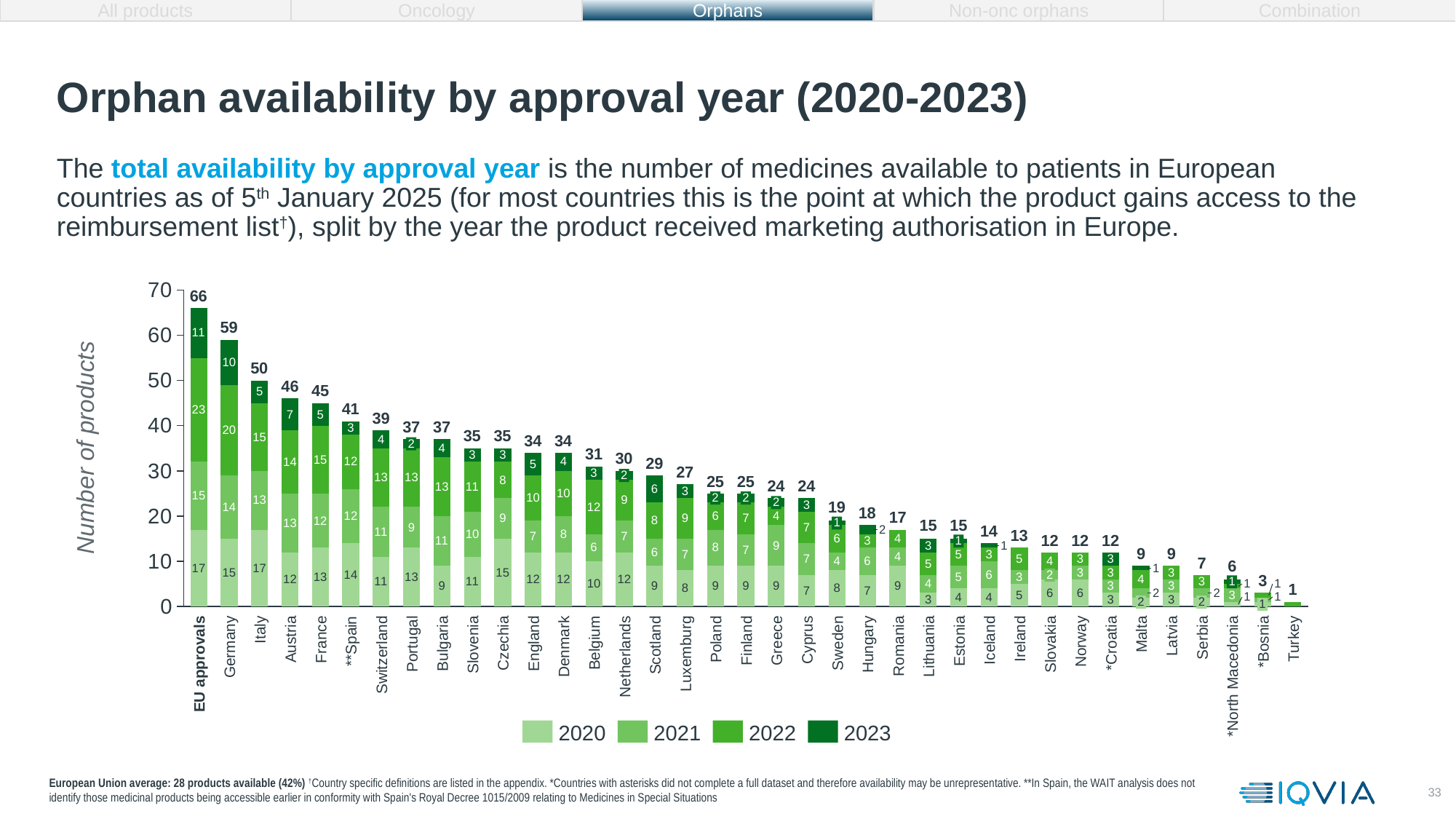
What is the total number of products for Switzerland? 39 How many products approved in 2022 are available in Germany? 20 What kind of chart is shown on the slide? Stacked bar chart What is the total number of products for Germany? 59 Which country has the lowest total number of products? Turkey Which bar has the highest total number of products? EU approvals Which has a higher total, Belgium or Netherlands? Belgium What is the label on the y axis? Number of products Do the bar totals rise or fall from left to right along the x axis? Fall What is the difference between the totals for Germany and Italy? 9 How many series does the legend list? 4 How many products approved in 2020 are available in Czechia? 15